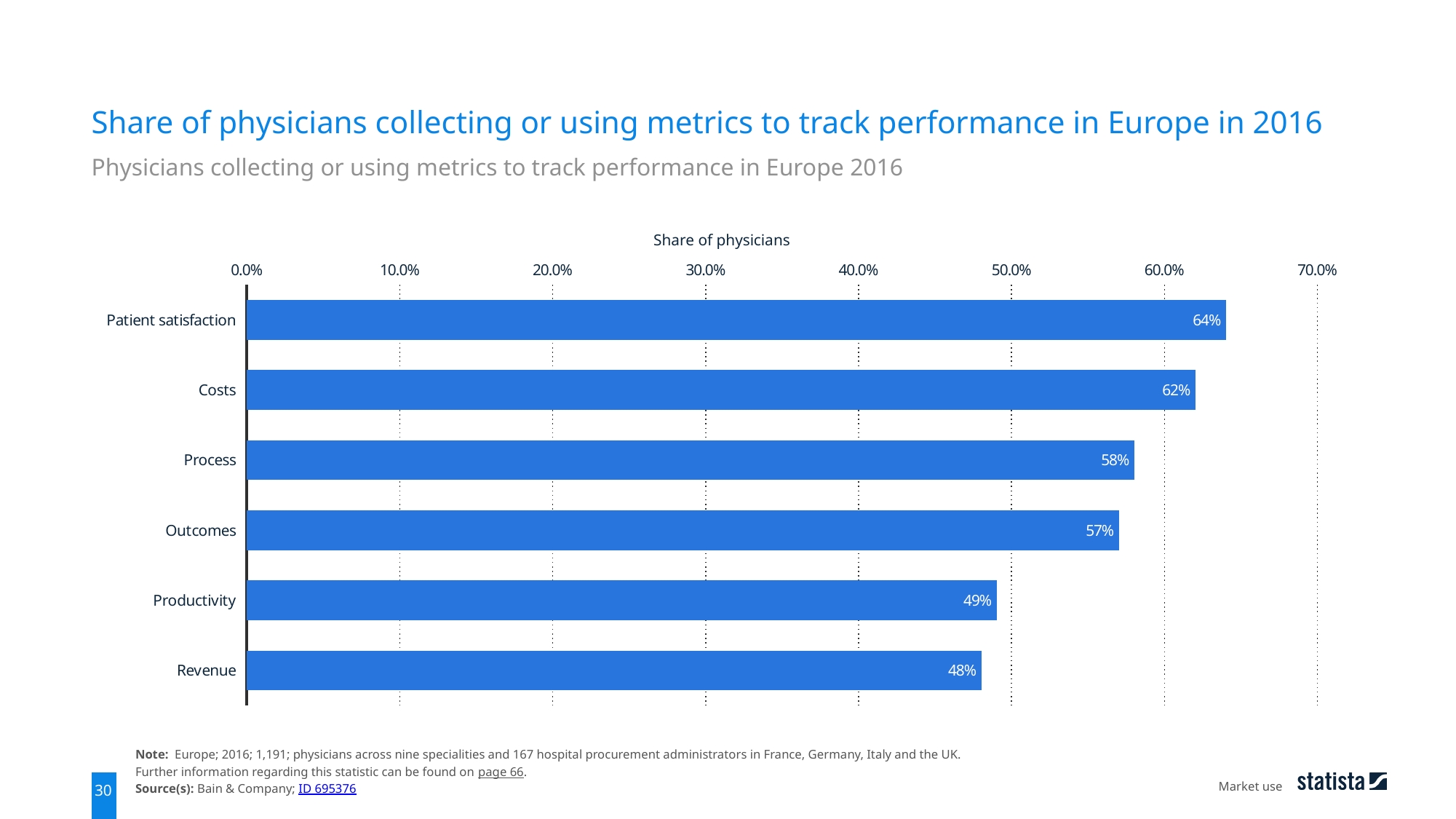
What is the share of physicians for Patient satisfaction? 64% What is the label of the horizontal axis? Share of physicians What is the share of physicians for Productivity? 49% What kind of chart is shown on the slide? Bar chart Which category has the lowest share of physicians? Revenue Which is larger, the share for Process or the share for Productivity? Process Which category has the highest share of physicians? Patient satisfaction What is the difference between the shares for Patient satisfaction and Revenue? 16% What is the difference between the shares for Costs and Process? 4% Is the value for Costs greater or less than 60.0%? greater How many categories are shown in the chart? 6 What is the share of physicians for Outcomes? 57%